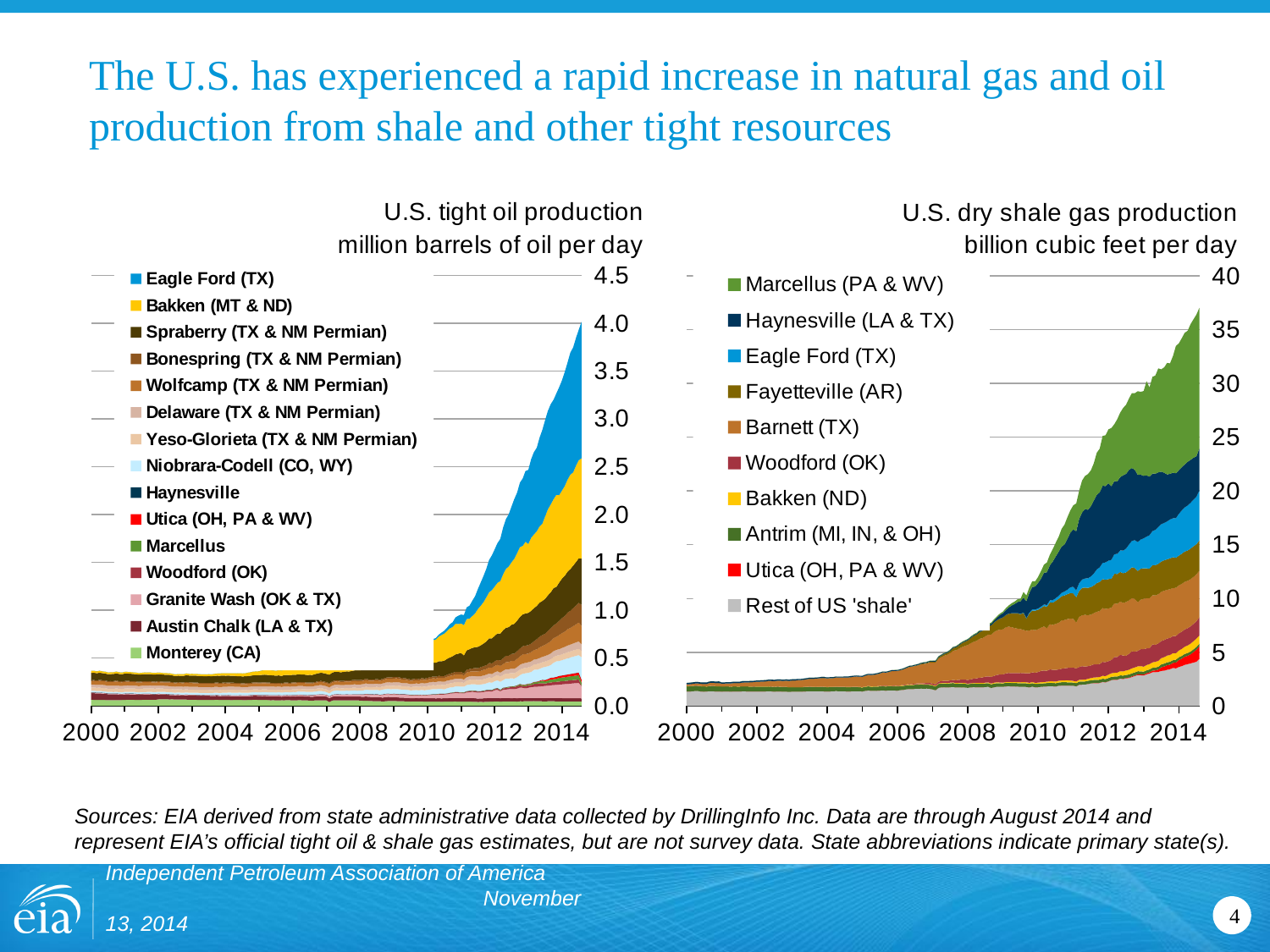
How many series does the legend of the 'U.S. tight oil production' chart list? 15 In the 'U.S. tight oil production' chart, is total production in 2014 greater or less than 3.5 million barrels per day? greater In the 'U.S. dry shale gas production' chart, which play contributes the largest share of production in 2014? Marcellus (PA & WV) In the 'U.S. dry shale gas production' chart, is total production in 2000 greater or less than 5 billion cubic feet per day? less In the 'U.S. tight oil production' chart, is total production in 2008 greater or less than 1.0 million barrels per day? less In the 'U.S. tight oil production' chart, does total production rise or fall from 2010 to 2014? Rise What kind of chart is the 'U.S. tight oil production' chart? Stacked area chart In the 'U.S. dry shale gas production' chart, what unit is production measured in? billion cubic feet per day In the 'U.S. tight oil production' chart, what unit is production measured in? million barrels of oil per day How many series does the legend of the 'U.S. dry shale gas production' chart list? 10 In the 'U.S. dry shale gas production' chart, does total production rise or fall from 2000 to 2014? Rise